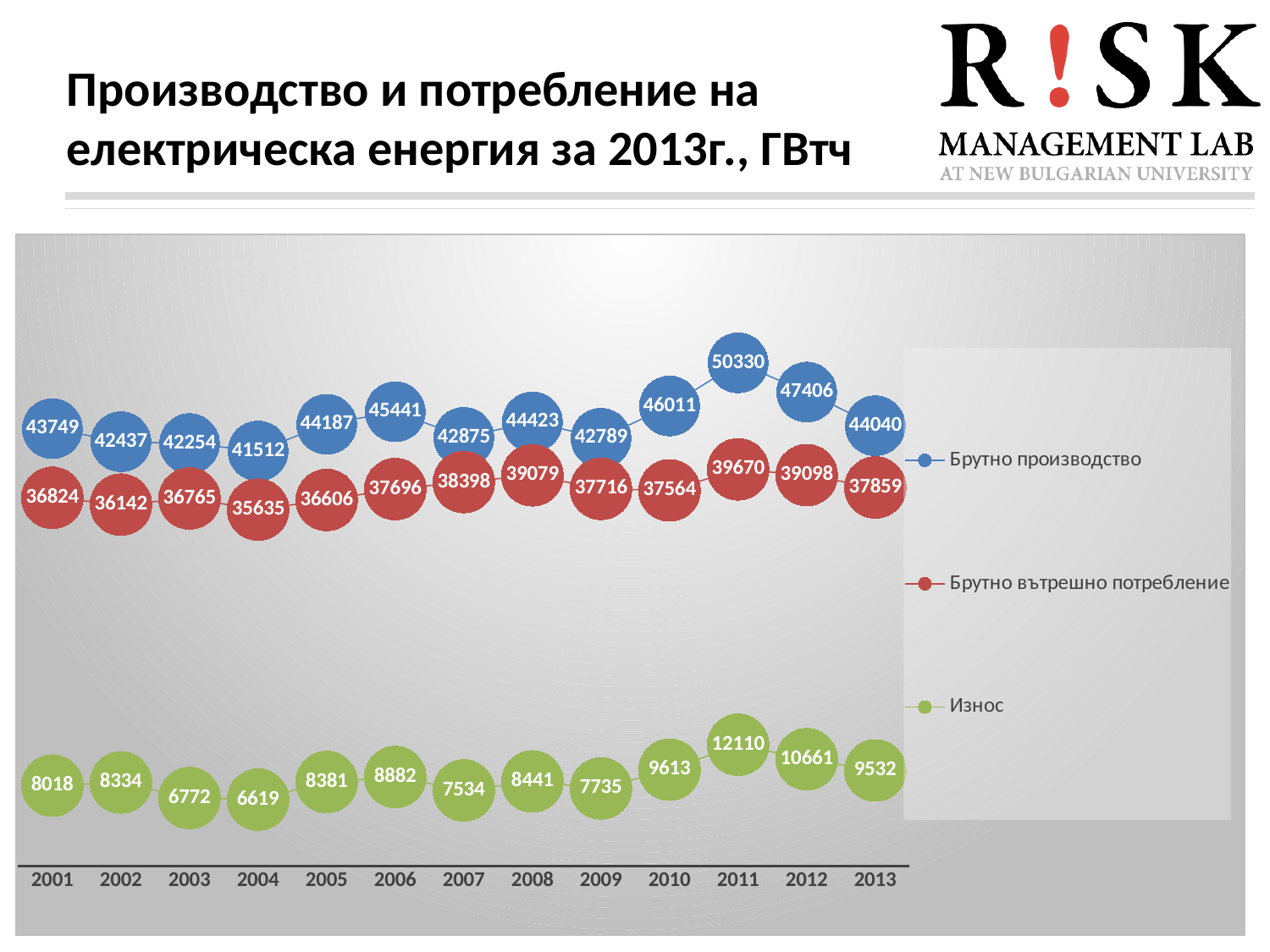
What is the value of Брутно вътрешно потребление for 2007? 38398 In which year is Брутно вътрешно потребление lowest? 2004 What kind of chart is shown on the slide? Line chart How many series does the legend list? 3 What is the difference between Брутно производство and Брутно вътрешно потребление in 2013? 6181 What is the value of Брутно производство for 2011? 50330 How many years are shown on the x axis? 13 Which is larger, Износ in 2012 or Износ in 2013? Износ in 2012 In which year is Износ lowest? 2004 In which year is Брутно производство highest? 2011 By how much did Износ increase from 2010 to 2011? 2497 What is the value of Износ for 2004? 6619